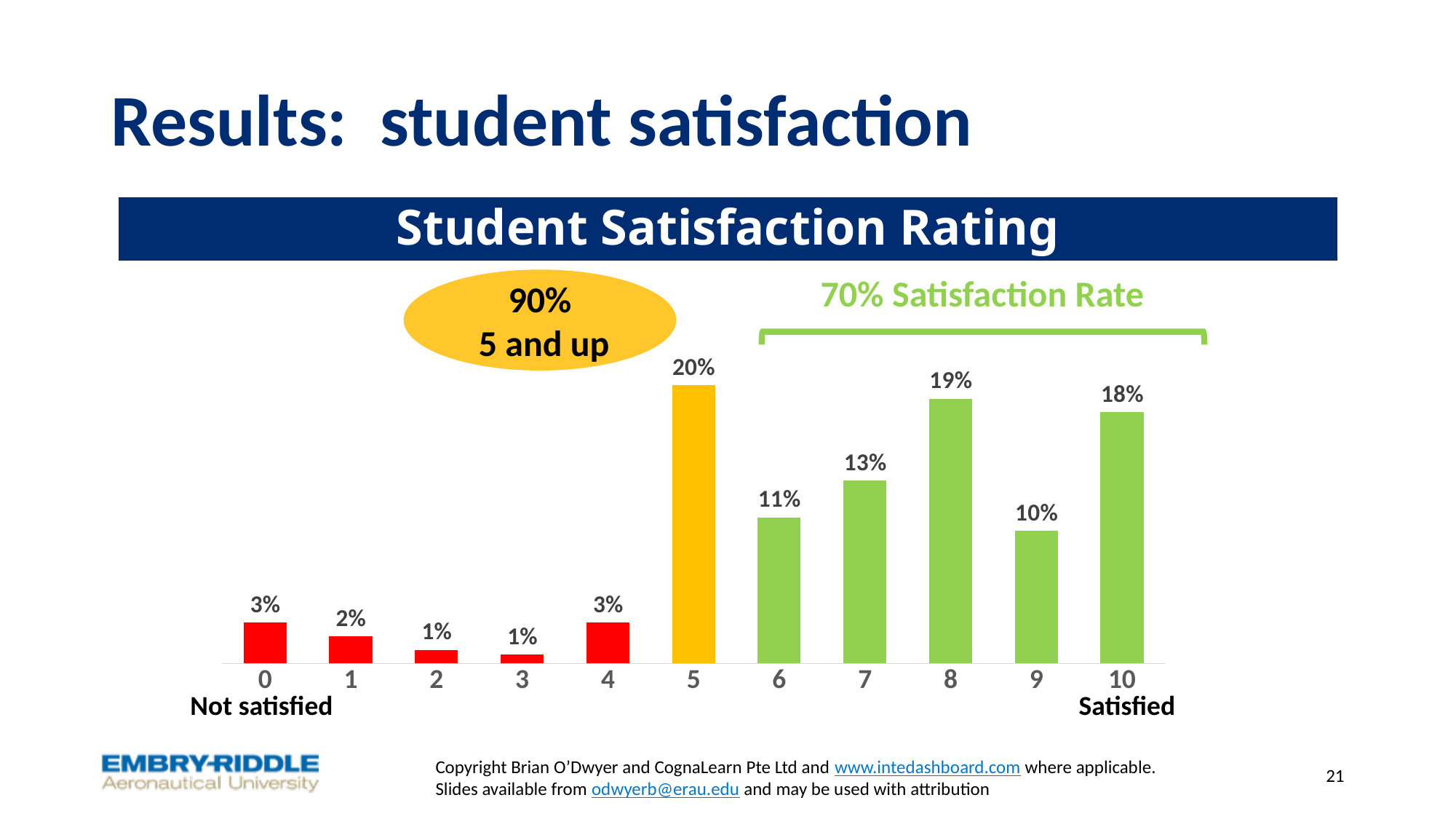
Which is larger, the value for rating 7 or the value for rating 6? rating 7 What is the value for rating 5? 20% What is the value for rating 0? 3% What is the value for rating 8? 19% What kind of chart is this? bar chart What colour are the bars for ratings 0 to 4? red How many rating categories are shown on the x axis? 11 What is the title of the chart? Student Satisfaction Rating What is the total of the values for ratings 6 through 10? 71% Which rating has the highest value? 5 What is the difference between the values for rating 10 and rating 9? 8% What is the difference between the values for rating 5 and rating 4? 17%